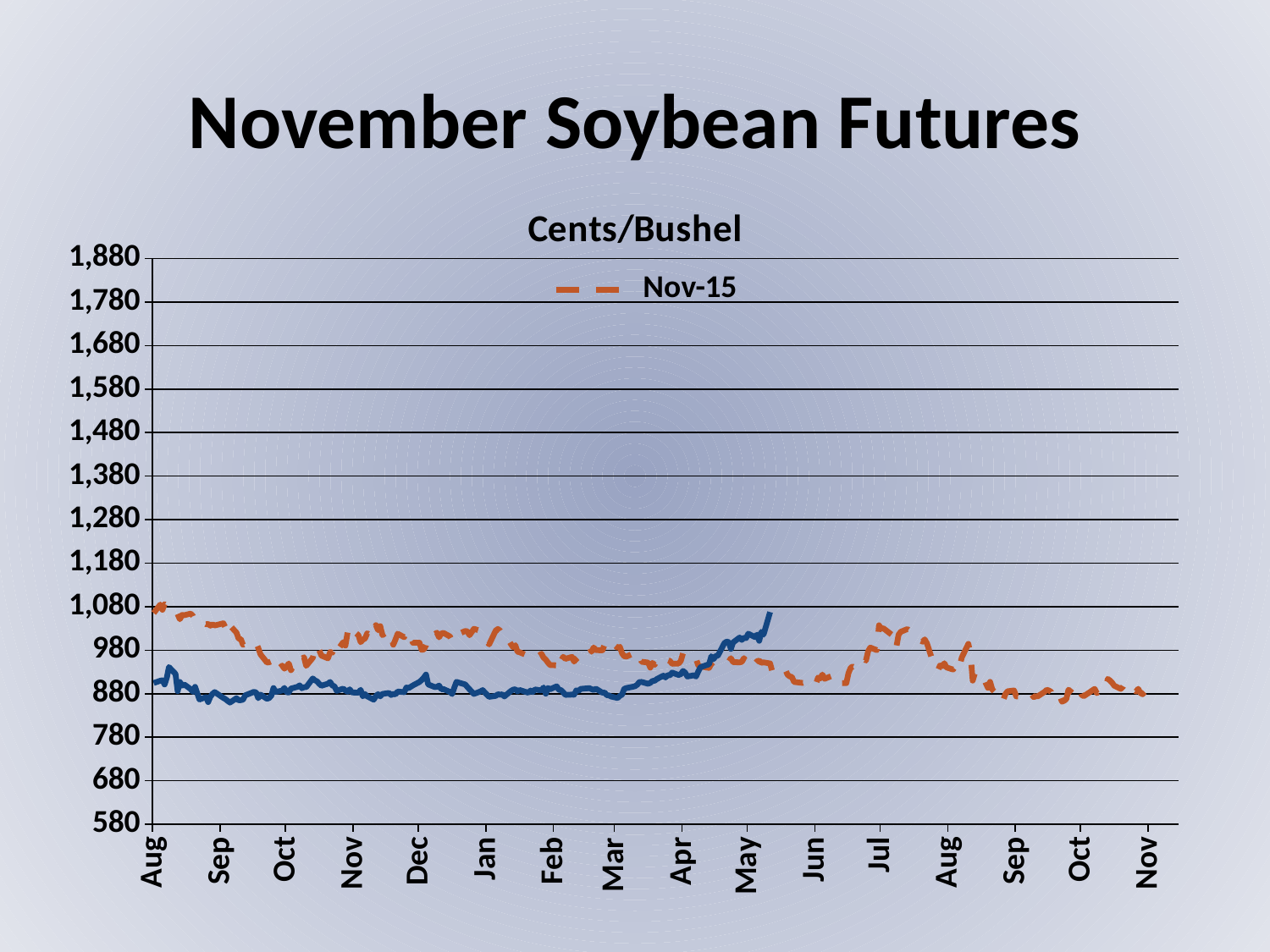
What kind of chart is shown on the slide? line chart Is the Nov-15 value at Jun greater or less than 980? less How many series does the legend list? 1 Is the value of the solid blue line at Mar greater or less than 980? less What is the name of the series listed in the legend? Nov-15 Does the Nov-15 series overall rise or fall from the first Aug to the final Nov? fall What is the title of the chart? Cents/Bushel How many month labels are shown along the x axis? 16 Does the solid blue line rise or fall from Mar to May? rise Is the Nov-15 value at Sep (the first Sep) greater or less than 980? greater